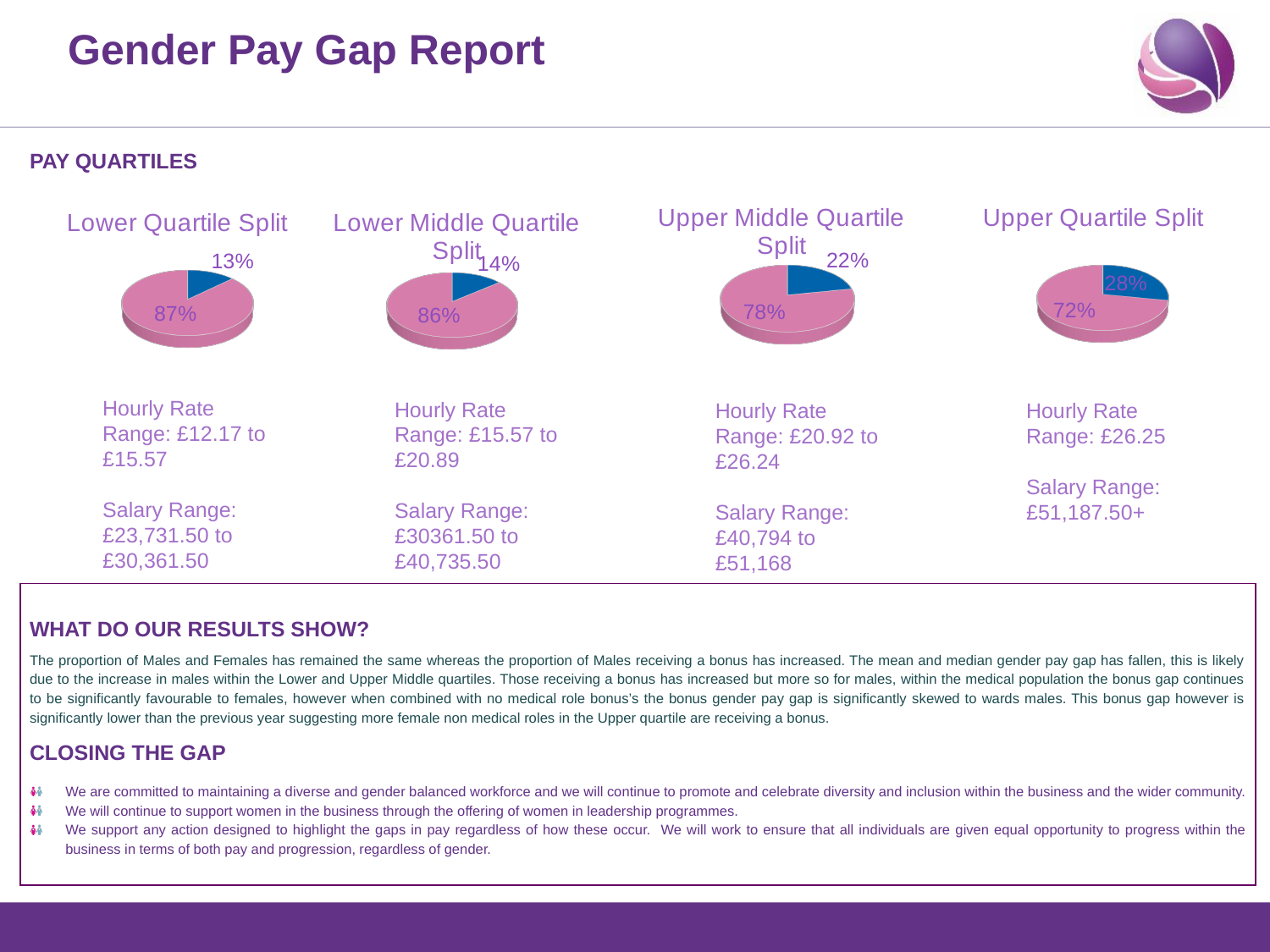
Across the four pie charts, which chart shows the smallest blue slice? Lower Quartile Split How many slices does the "Upper Quartile Split" pie chart have? 2 In the "Upper Middle Quartile Split" chart, what percentage is shown for the larger (pink) slice? 78% In the "Lower Quartile Split" chart, what percentage is shown for the smaller (blue) slice? 13% Across the four pie charts, which chart shows the largest pink slice? Lower Quartile Split Which chart has the largest blue slice: "Lower Quartile Split" or "Upper Quartile Split"? Upper Quartile Split How many pie charts are shown on the slide? 4 In the "Lower Quartile Split" chart, what percentage is shown for the larger slice? 87% In the "Upper Quartile Split" chart, what percentage is shown for the smaller (blue) slice? 28% In the "Upper Middle Quartile Split" chart, what is the difference between the two slice percentages? 56% What kind of chart is the "Lower Quartile Split" chart? Pie chart In the "Lower Middle Quartile Split" chart, what percentage is shown for the smaller (blue) slice? 14%